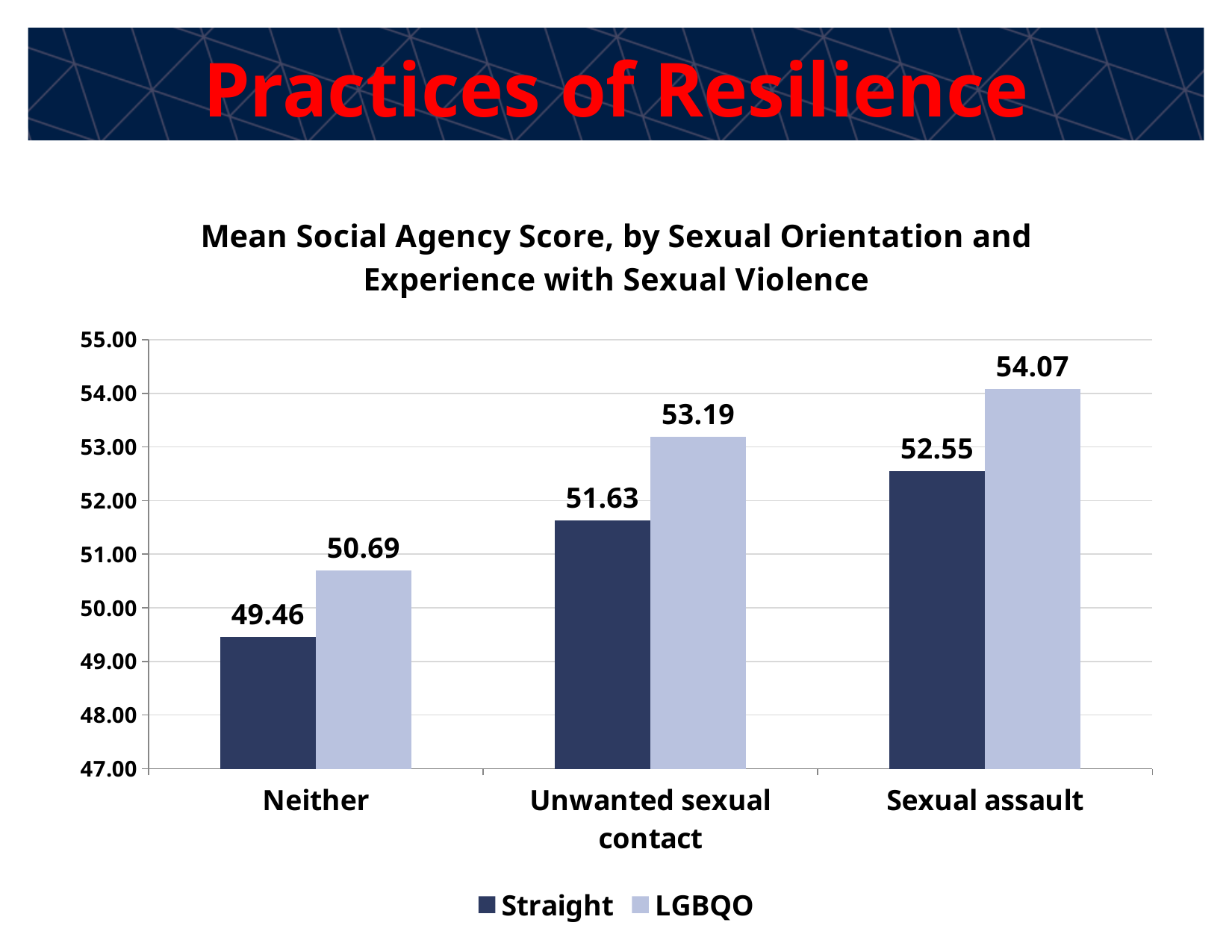
What is the mean social agency score for LGBQO respondents in the Unwanted sexual contact category? 53.19 What is the difference between the LGBQO and Straight scores in the Sexual assault category? 1.52 How many series does the legend list? 2 Do the Straight scores rise or fall moving from Neither to Sexual assault along the x axis? Rise How many experience categories are shown on the x axis? 3 Which category has the highest mean social agency score for Straight respondents? Sexual assault Which category has the lowest mean social agency score for LGBQO respondents? Neither What is the mean social agency score for LGBQO respondents who experienced sexual assault? 54.07 Which is larger: the Straight score for Unwanted sexual contact or the LGBQO score for Neither? Straight score for Unwanted sexual contact What is the difference between the Straight scores for Unwanted sexual contact and Neither? 2.17 What is the mean social agency score for Straight respondents in the Neither category? 49.46 What kind of chart is shown on the slide? Bar chart